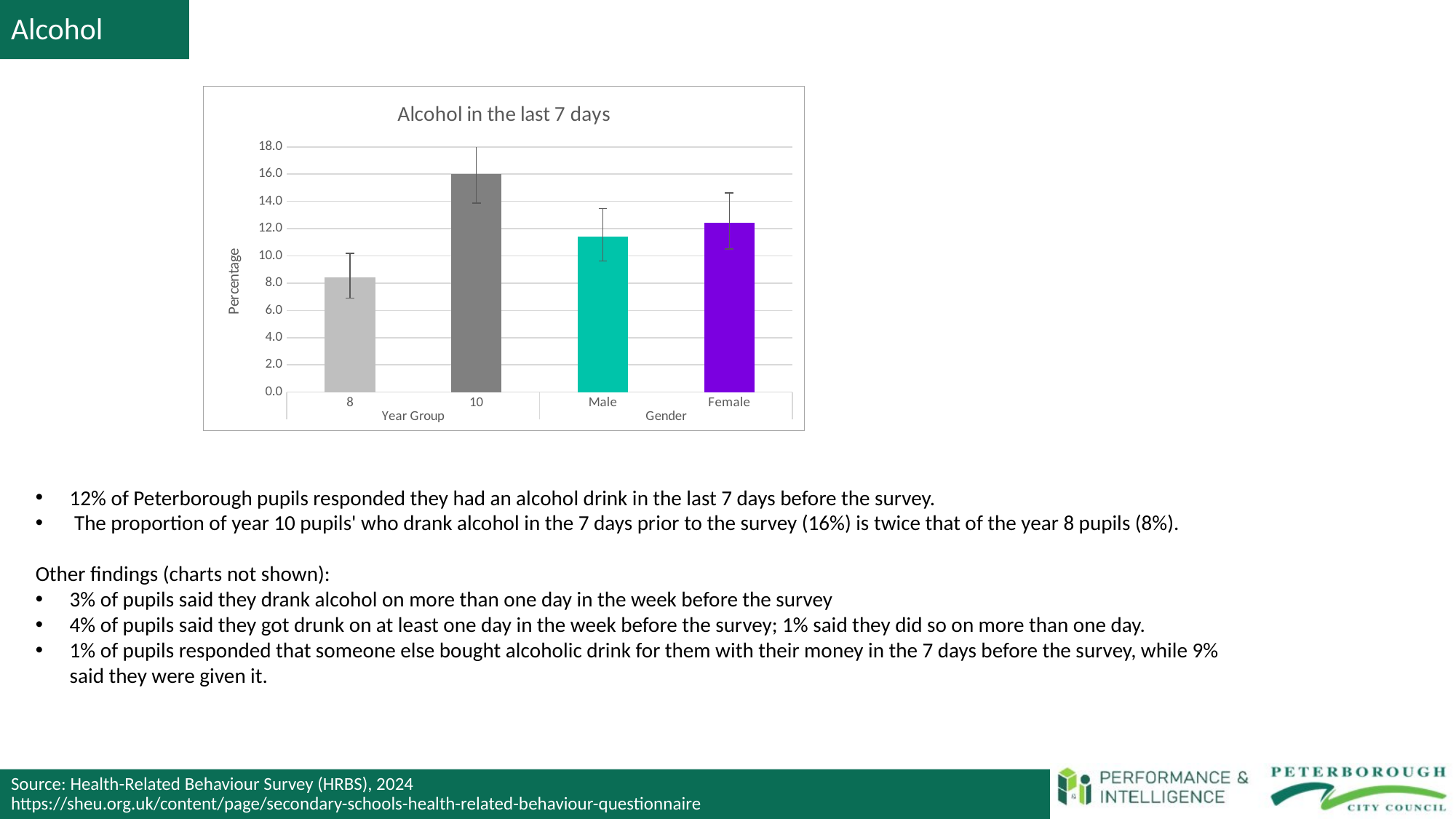
Is the value for Male greater or less than 10.0? greater Which category has the highest value in the chart? 10 Is the value for Female greater or less than 10.0? greater What kind of chart is shown on the slide? bar chart Which is larger, the value for Male or the value for Female? Female Which is larger, the value for year group 10 or the value for Female? 10 What is the label on the vertical axis of the chart? Percentage How many bars are plotted in the chart? 4 What is the title of the chart? Alcohol in the last 7 days Which category has the lowest value in the chart? 8 Is the value for year group 8 greater or less than 10.0? less